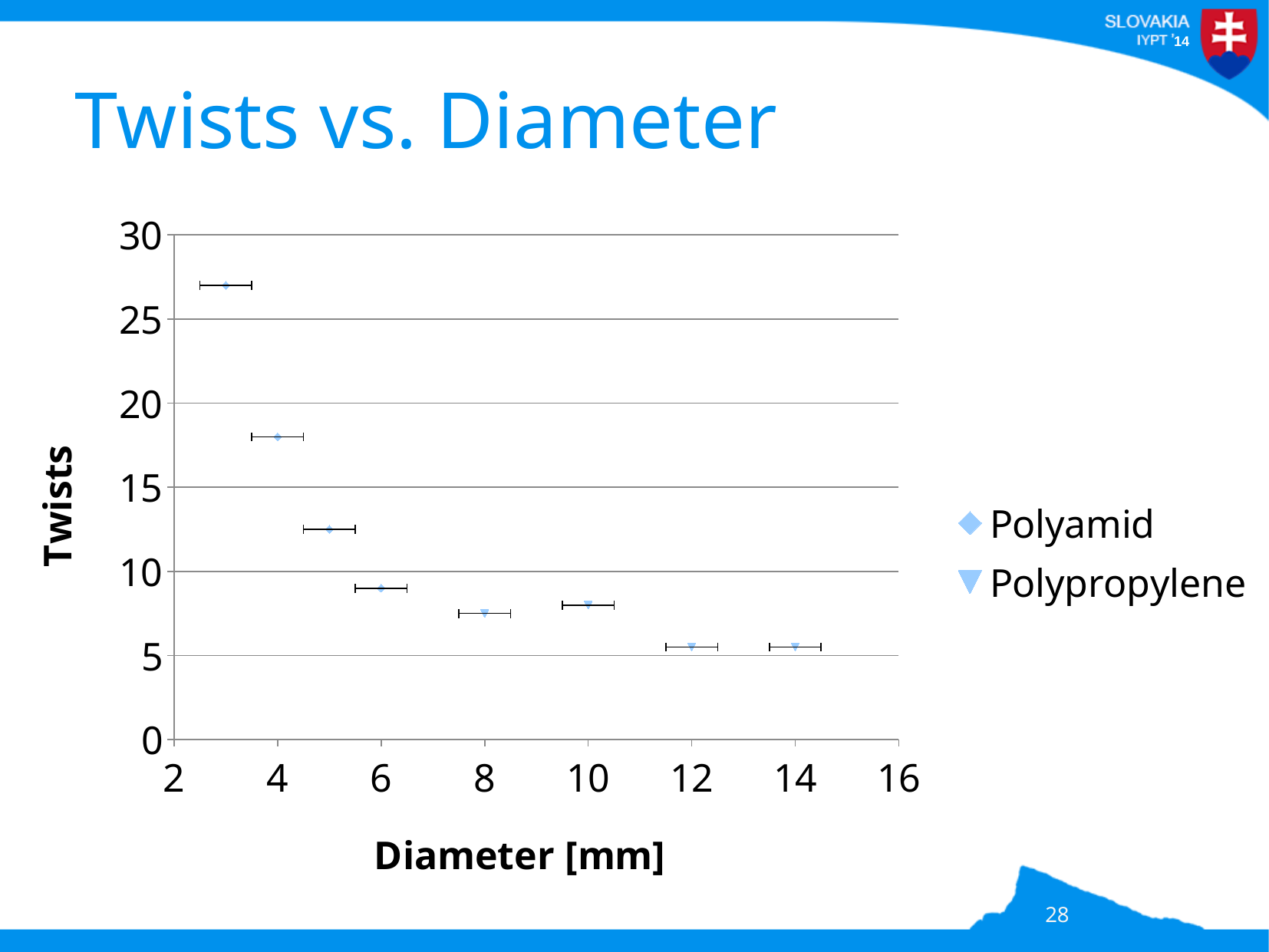
How many series does the legend list? 2 What is the title of the chart? Twists vs. Diameter Is the Polyamid value at a diameter of 3 mm greater or less than 25 twists? greater What kind of chart is shown on the slide? scatter chart Do the Polyamid twists rise or fall as the diameter increases? fall Is the Polyamid value at a diameter of 6 mm greater or less than 10 twists? less Is the Polypropylene value at a diameter of 10 mm greater or less than 10 twists? less How many data points are plotted in total across both series? 8 Which two series are listed in the legend? Polyamid and Polypropylene At which diameter is the number of twists highest? 3 mm How many data points are plotted for the Polyamid series? 4